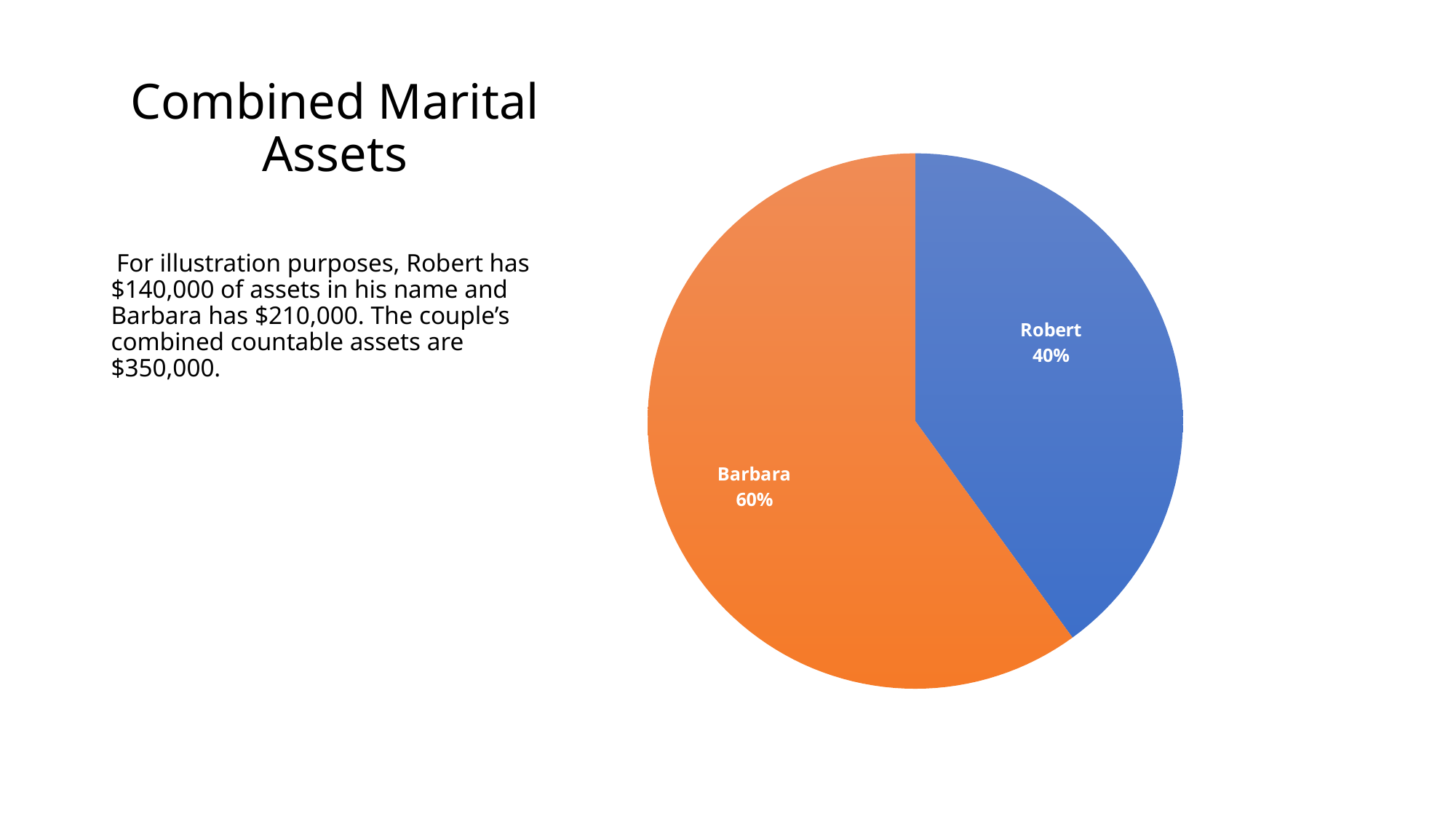
How many slices does the pie chart have? 2 Which is larger, Robert's share or Barbara's share? Barbara What kind of chart is shown on the slide? pie chart What share of the pie does Barbara's slice represent? 60% Which slice of the pie is the smallest? Robert What colour is Barbara's slice? orange Which slice of the pie is the largest? Barbara What is the difference in percentage points between Barbara's share and Robert's share? 20% What share of the pie does Robert's slice represent? 40% What colour is Robert's slice? blue